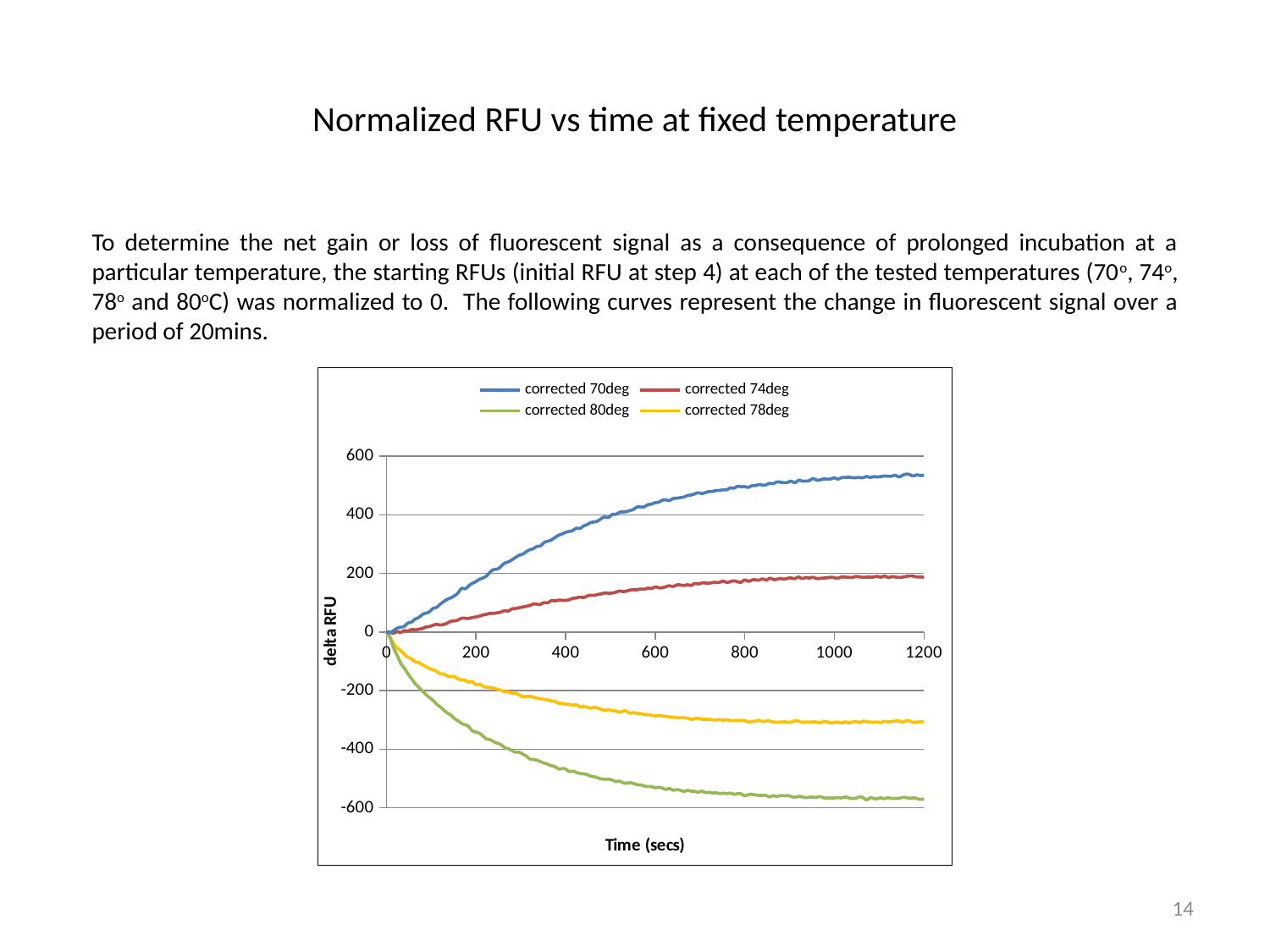
Is the value of the corrected 74deg series at 1200 secs greater or less than 200? less Is the value of the corrected 70deg series at 1200 secs greater or less than 400? greater What is the label of the chart's horizontal axis? Time (secs) Does the corrected 70deg series rise or fall as time increases? rise Which series reaches the highest delta RFU value by the end of the time period? corrected 70deg Does the corrected 80deg series rise or fall as time increases? fall Is the value of the corrected 78deg series at 1200 secs greater or less than -200? less At 1200 secs, which series has the larger delta RFU value: corrected 74deg or corrected 78deg? corrected 74deg How many series does the chart's legend list? 4 What is the label of the chart's vertical axis? delta RFU Which series reaches the lowest delta RFU value by the end of the time period? corrected 80deg What kind of chart is shown on the slide? line chart